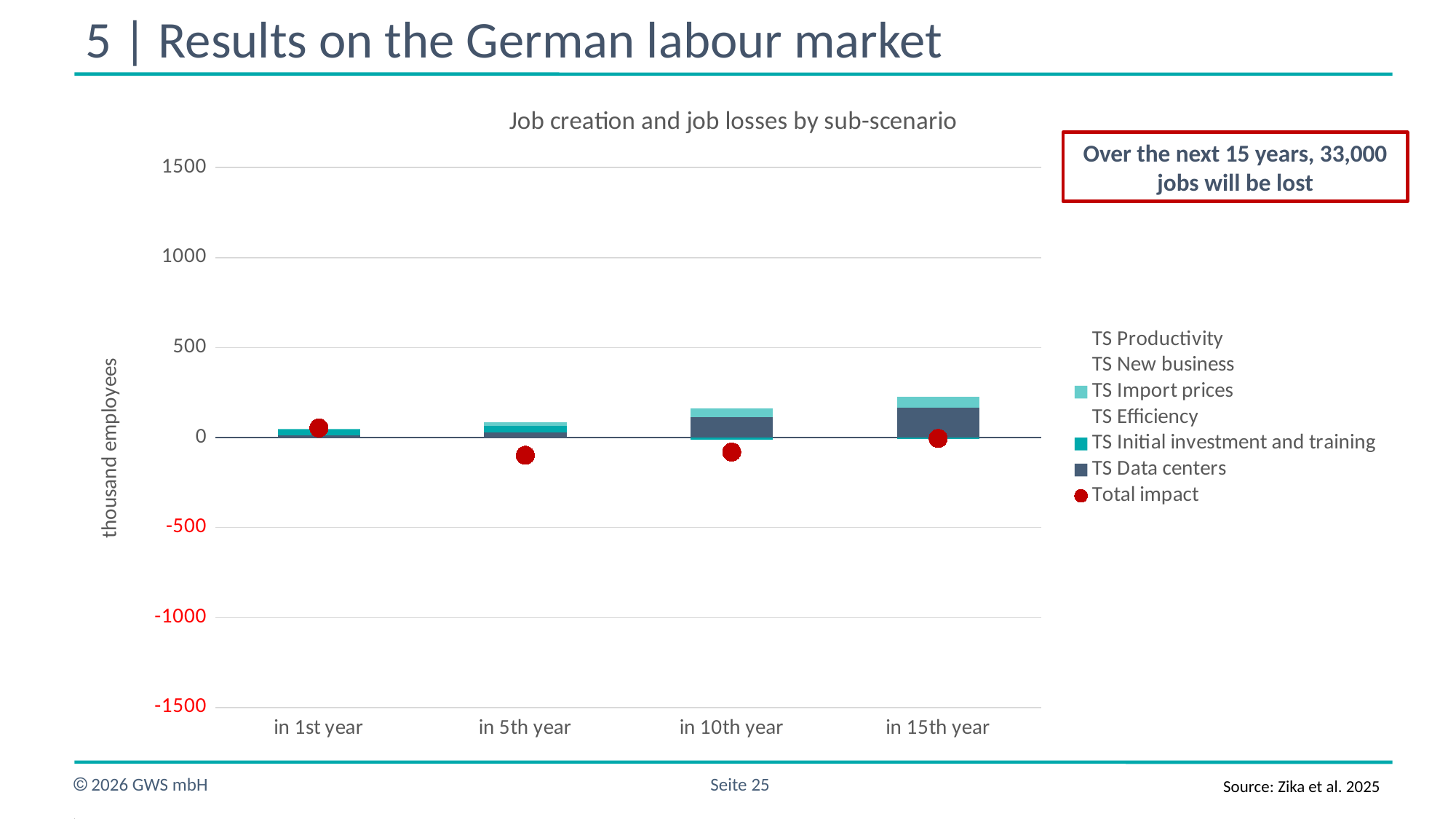
Is the Total impact value in the 5th year greater or less than 0? less How many categories are shown on the x axis of the chart? 4 Is the Total impact value in the 1st year greater or less than 0? greater In which year is the Total impact dot highest? in 1st year Do the positive stacked bars rise or fall from the 1st year to the 15th year? rise What is the title of the chart? Job creation and job losses by sub-scenario Which is larger, the Total impact in the 1st year or in the 5th year? in 1st year What is the label on the vertical axis of the chart? thousand employees How many series does the chart legend list? 7 Which year has the tallest stacked bar above zero? in 15th year Is the top of the stacked bar in the 15th year greater or less than 500? less What kind of chart is shown on the slide? Bar chart (stacked) with a dot series for Total impact